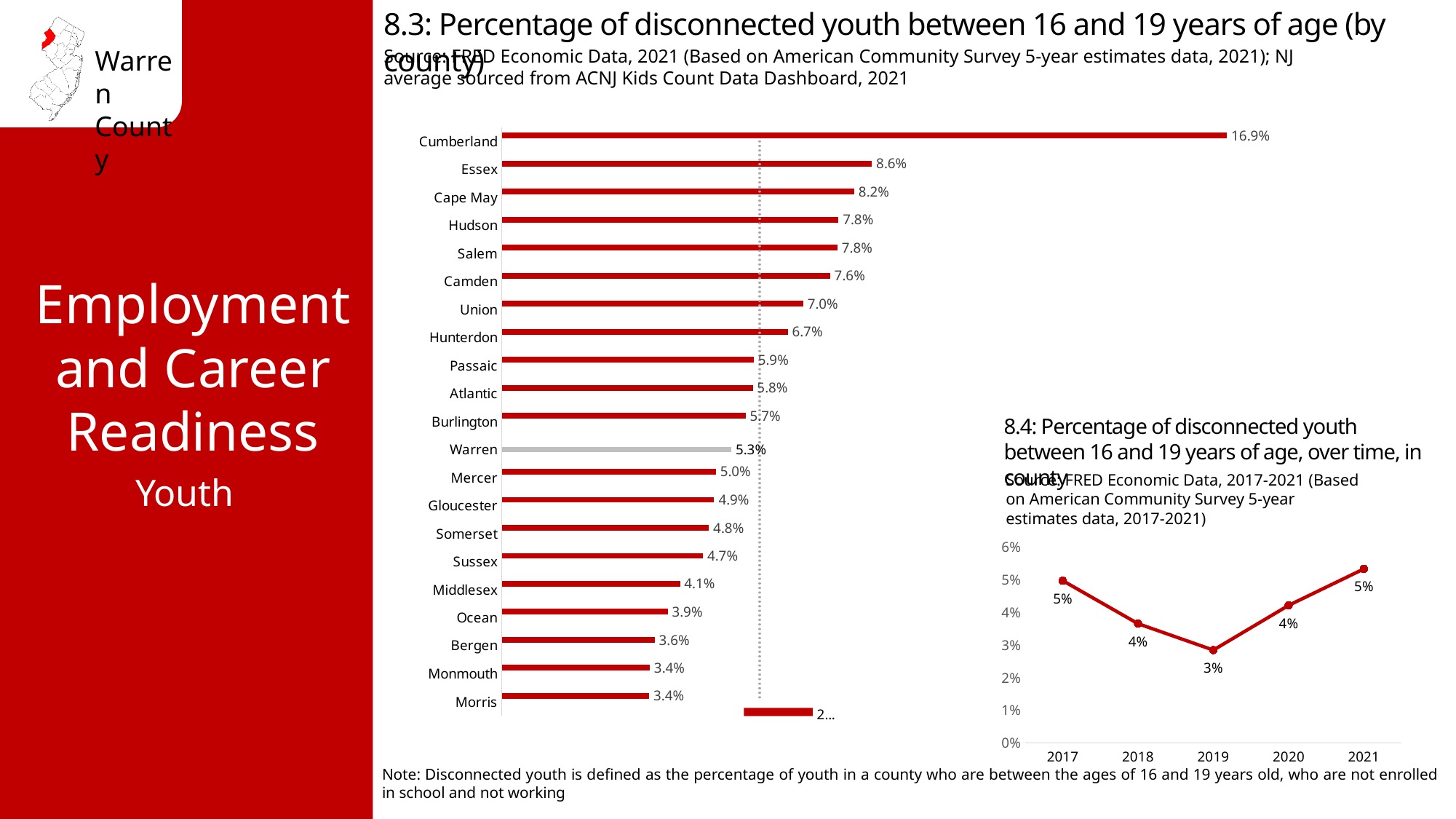
In chart 8.3 (percentage of disconnected youth by county), which is larger, the value for Hunterdon or the value for Passaic? Hunterdon In chart 8.4 (percentage of disconnected youth over time), which year has the lowest value? 2019 In chart 8.3 (percentage of disconnected youth by county), which bar is shown in grey rather than red? Warren In chart 8.4 (percentage of disconnected youth over time), what is the value for 2019? 3% In chart 8.3 (percentage of disconnected youth by county), what is the value for Middlesex? 4.1% In chart 8.4 (percentage of disconnected youth over time), how many years are plotted? 5 In chart 8.3 (percentage of disconnected youth by county), what is the value for Warren? 5.3% In chart 8.3 (percentage of disconnected youth by county), what is the value for Cape May? 8.2% What kind of chart is chart 8.4 (percentage of disconnected youth over time)? Line chart In chart 8.3 (percentage of disconnected youth by county), which county has the highest value? Cumberland What kind of chart is chart 8.3 (percentage of disconnected youth by county)? Bar chart In chart 8.3 (percentage of disconnected youth by county), what is the difference between Cumberland and Essex? 8.3%